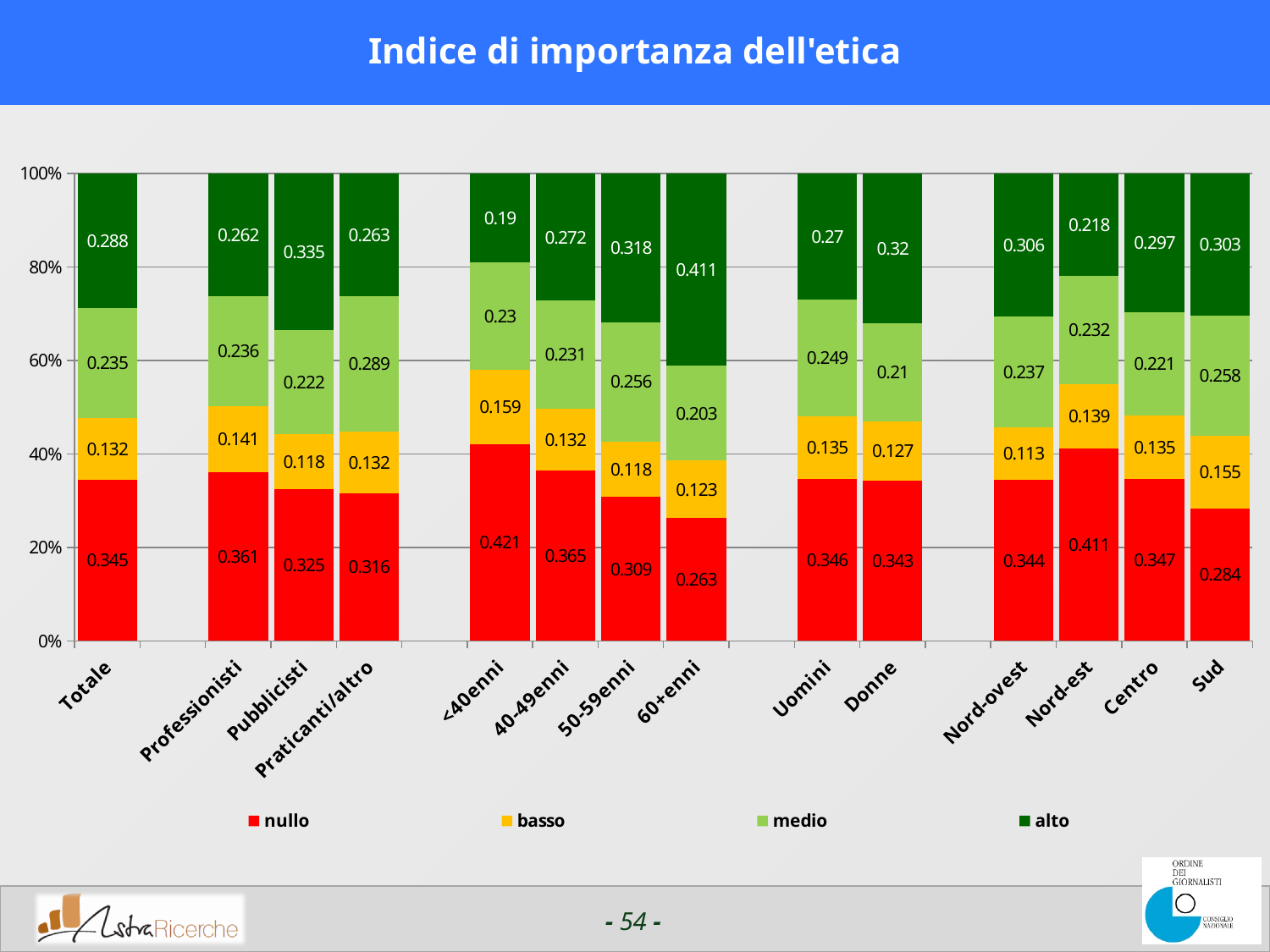
Which category has the highest 'alto' value? 60+enni How many series does the legend list? 4 What is the value of the 'nullo' segment for Totale? 0.345 How many categories are shown on the x axis? 14 Which category has the lowest 'nullo' value? 60+enni What is the value of the 'medio' segment for Praticanti/altro? 0.289 Which has a larger 'basso' value, Sud or Uomini? Sud What is the difference between the 'alto' values for 60+enni and <40enni? 0.221 What kind of chart is shown on the slide? Stacked bar chart What is the value of the 'alto' segment for 60+enni? 0.411 Which category has the lowest 'alto' value? <40enni What is the value of the 'basso' segment for Nord-ovest? 0.113